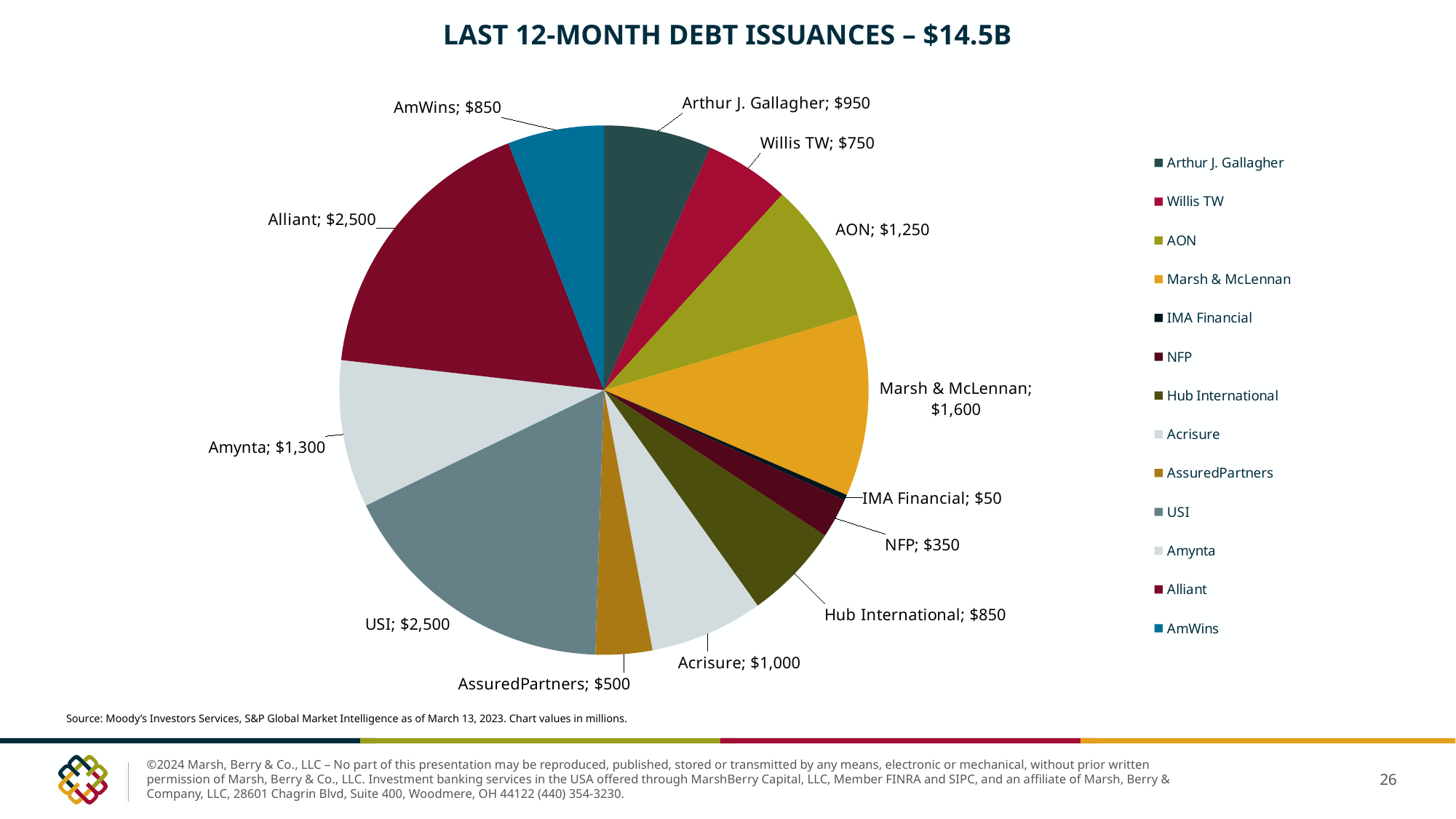
What is the difference between the values for USI and Acrisure? $1,500 How many entries does the legend list? 13 Which is larger, the value for Amynta or the value for AON? Amynta What is the value for Amynta in the pie chart? $1,300 What is the difference between the values for AON and Willis TW? $500 What is the value for Hub International in the pie chart? $850 What is the title of the chart? LAST 12-MONTH DEBT ISSUANCES – $14.5B Which is larger, the value for Arthur J. Gallagher or the value for NFP? Arthur J. Gallagher How many companies are shown in the pie chart? 13 Which company has the smallest slice in the pie chart? IMA Financial What is the value for Marsh & McLennan in the pie chart? $1,600 What kind of chart is shown on the slide? Pie chart